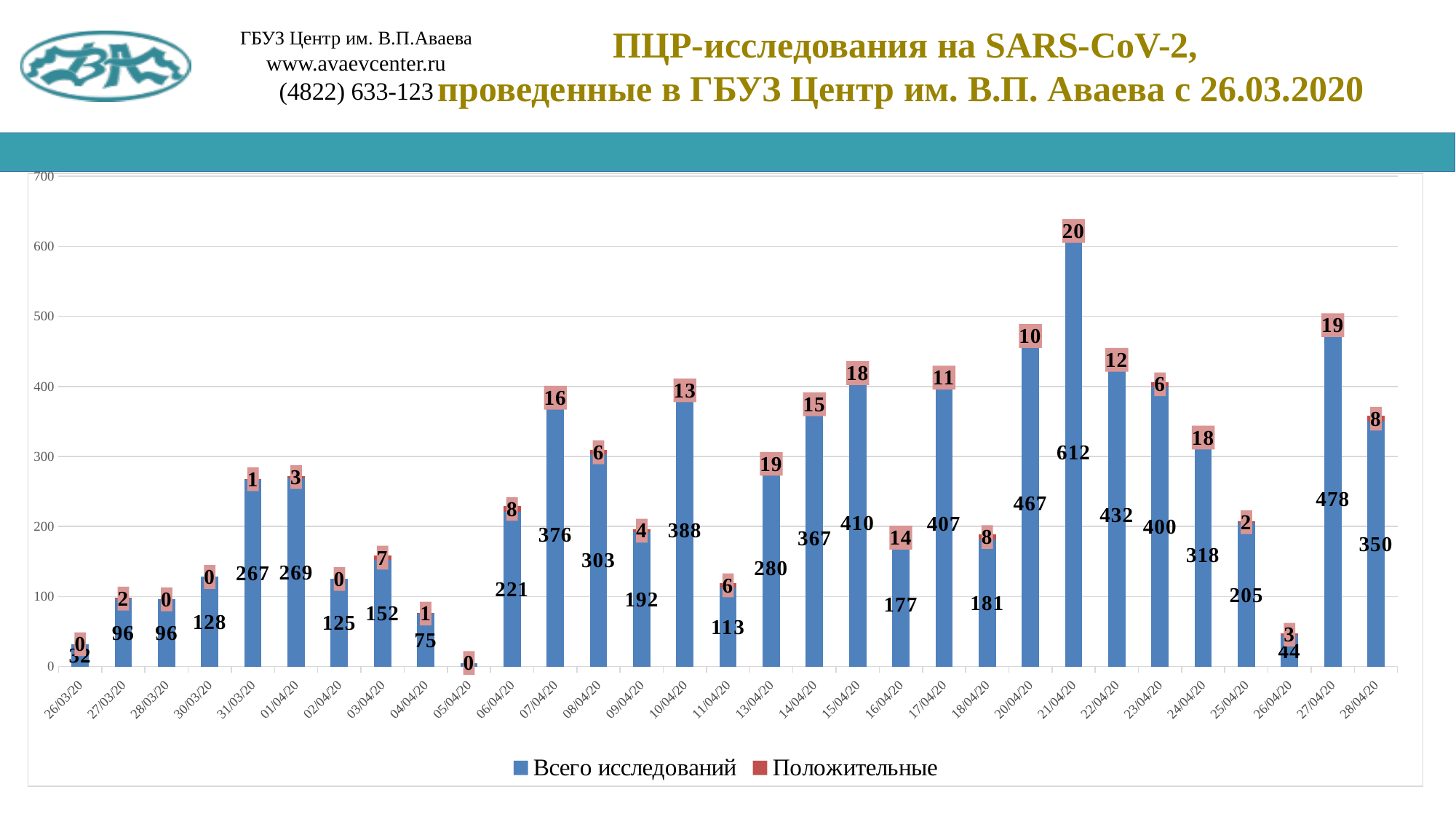
What kind of chart is shown on the slide? Stacked bar chart How many series does the legend list? 2 On which date was the number of total tests (Всего исследований) the lowest? 05/04/20 How many positive results (Положительные) were recorded on 07/04/20? 16 On which date was the number of positive results (Положительные) the highest? 21/04/20 On which date was the number of total tests (Всего исследований) the highest? 21/04/20 What is the combined height of the stacked bar for 24/04/20 (total tests plus positive results)? 336 How many tests in total (Всего исследований) were performed on 21/04/20? 612 What is the difference between the total tests on 27/04/20 and on 28/04/20? 128 Is the total tests value for 20/04/20 greater or less than 400? greater Which date had more total tests: 15/04/20 or 17/04/20? 15/04/20 How many dates are shown on the x axis of the chart? 31